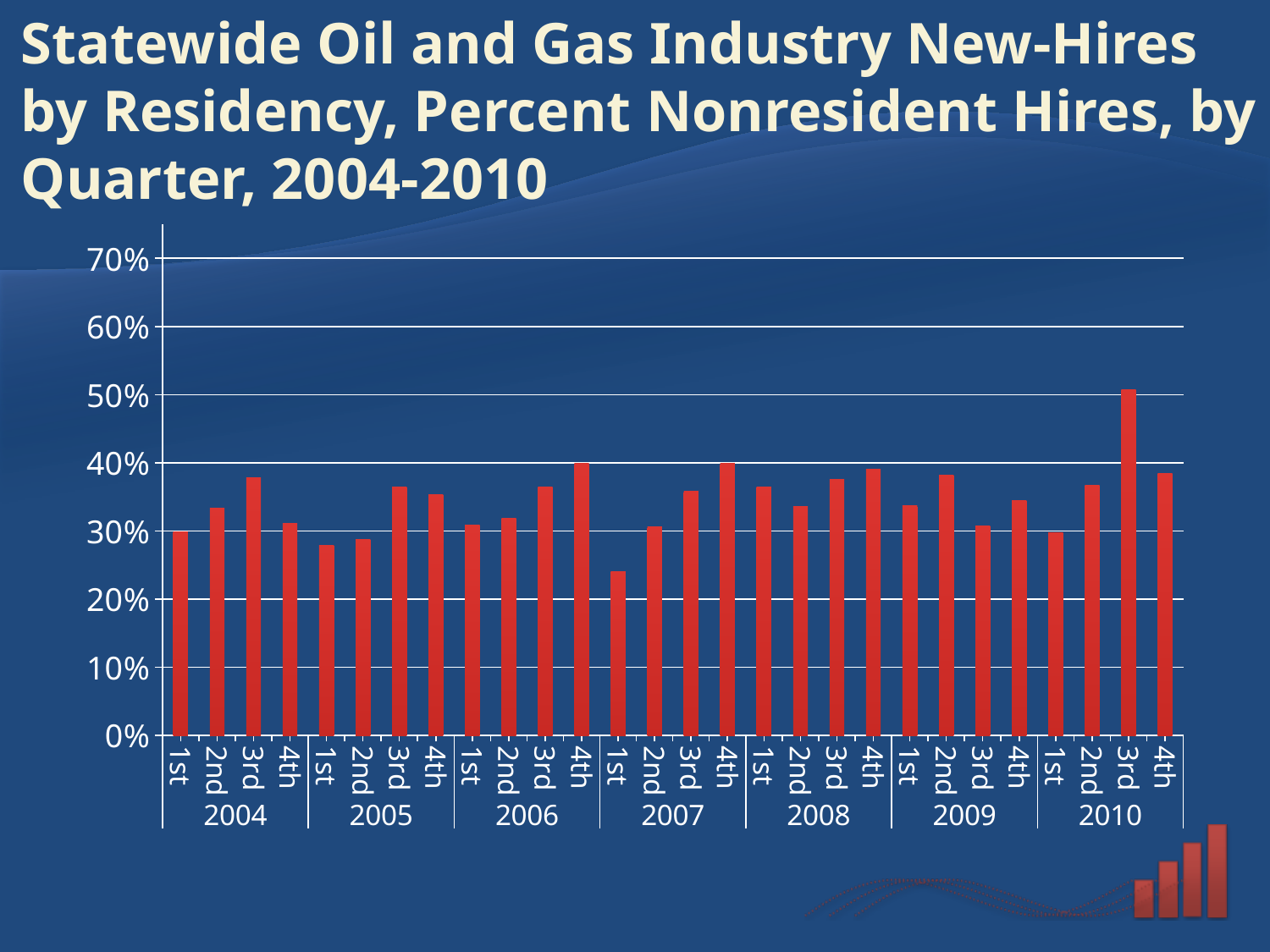
Which is larger, the value for the 1st quarter of 2004 or the 3rd quarter of 2004? 3rd quarter 2004 Which quarter has the lowest percent of nonresident hires? 1st quarter 2007 What is the highest value shown on the y axis of the chart? 70% Is the value for the 1st quarter of 2007 greater or less than 30%? less Is the value for the 1st quarter of 2005 greater or less than 30%? less Is the value for the 4th quarter of 2006 greater or less than 30%? greater Which quarter has the highest percent of nonresident hires? 3rd quarter 2010 Which is larger, the value for the 1st quarter of 2007 or the 4th quarter of 2007? 4th quarter 2007 How many years are shown along the x axis of the chart? 7 How many bars (quarters) are plotted in the chart? 28 What kind of chart is shown on the slide? bar chart